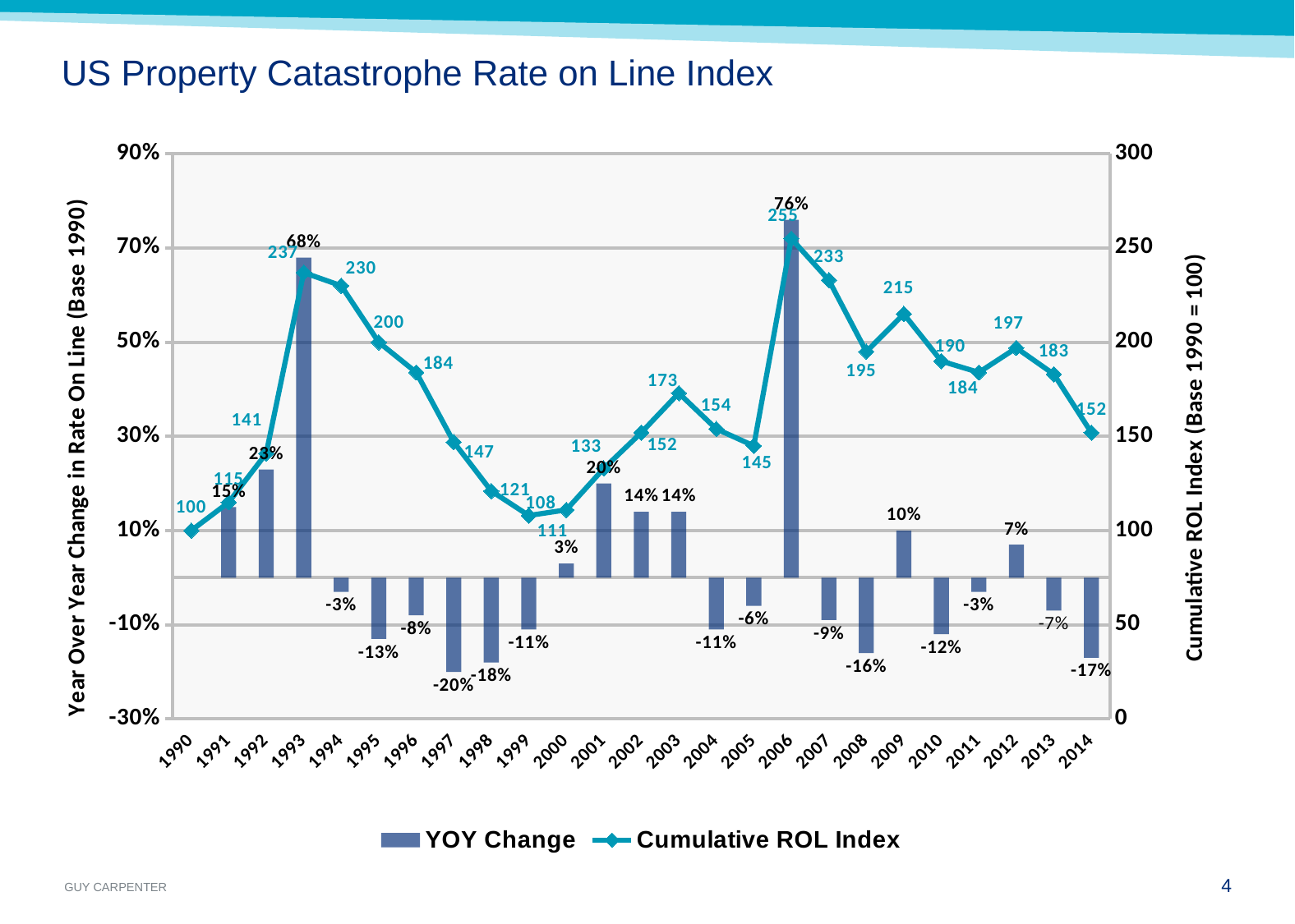
How many years are shown on the x axis? 25 Does the Cumulative ROL Index rise or fall from 2012 to 2014? Fall What is the difference between the Cumulative ROL Index in 2006 and in 2007? 22 Which year has the lowest YOY Change? 1997 What is the Cumulative ROL Index value for 1999? 108 Which year has the highest YOY Change? 2006 What is the YOY Change for 2014? -17% What is the YOY Change for 1993? 68% Which is larger, the Cumulative ROL Index in 1993 or in 2009? 1993 What kind of chart is this? Combined bar and line chart What is the Cumulative ROL Index value for 2006? 255 How many series does the legend list? 2